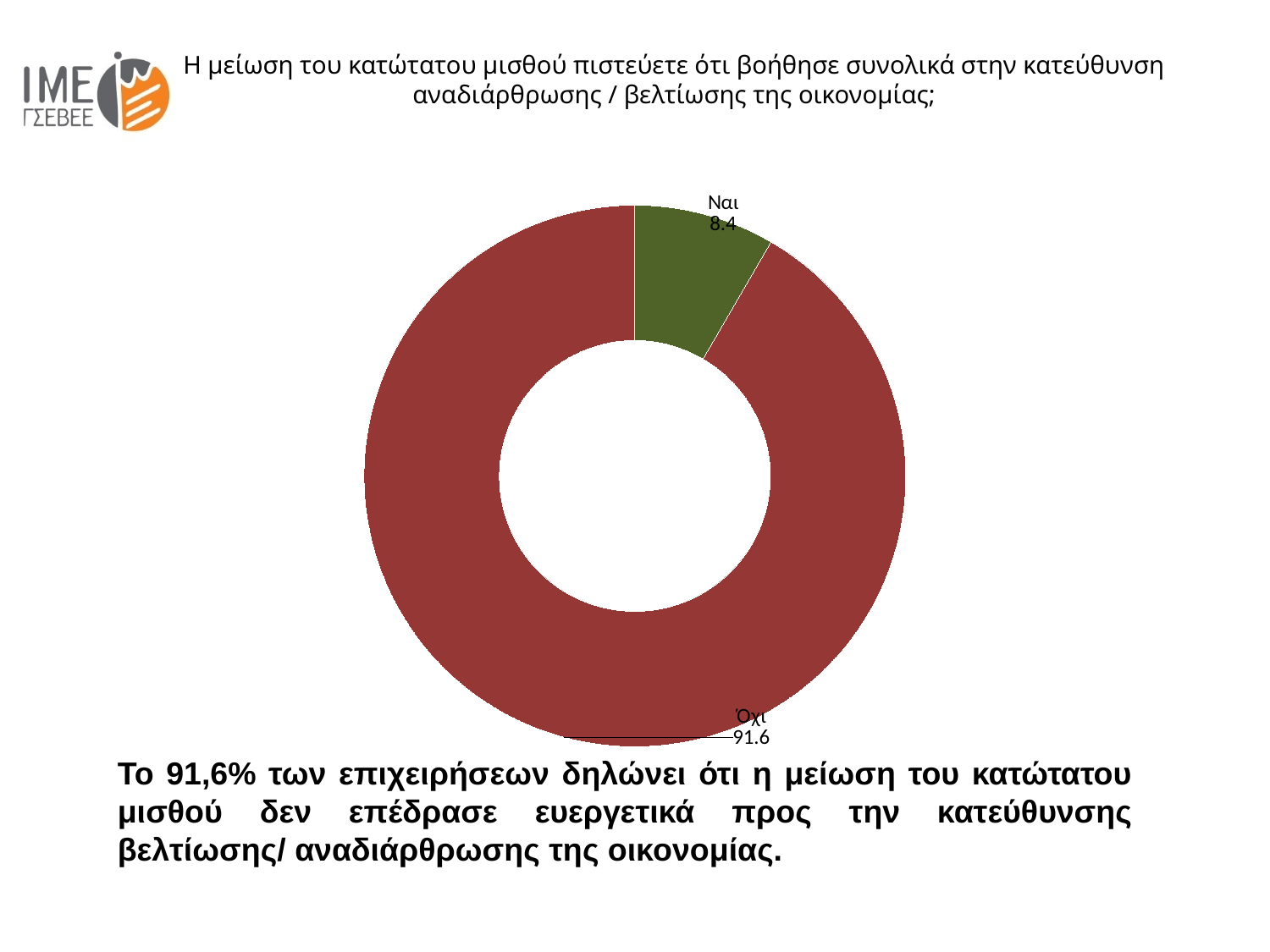
How many categories are shown in the chart? 2 What is the total of the two values shown in the chart? 100 What is the difference between the values for "Όχι" and "Ναι"? 83.2 What kind of chart is shown on the slide? Doughnut chart Which is larger, the value for "Ναι" or the value for "Όχι"? Όχι What value is shown for the "Όχι" slice? 91.6 Which category has the largest slice? Όχι What colour is the "Ναι" slice? Green What colour is the "Όχι" slice? Red What value is shown for the "Ναι" slice? 8.4 Which category has the smallest slice? Ναι